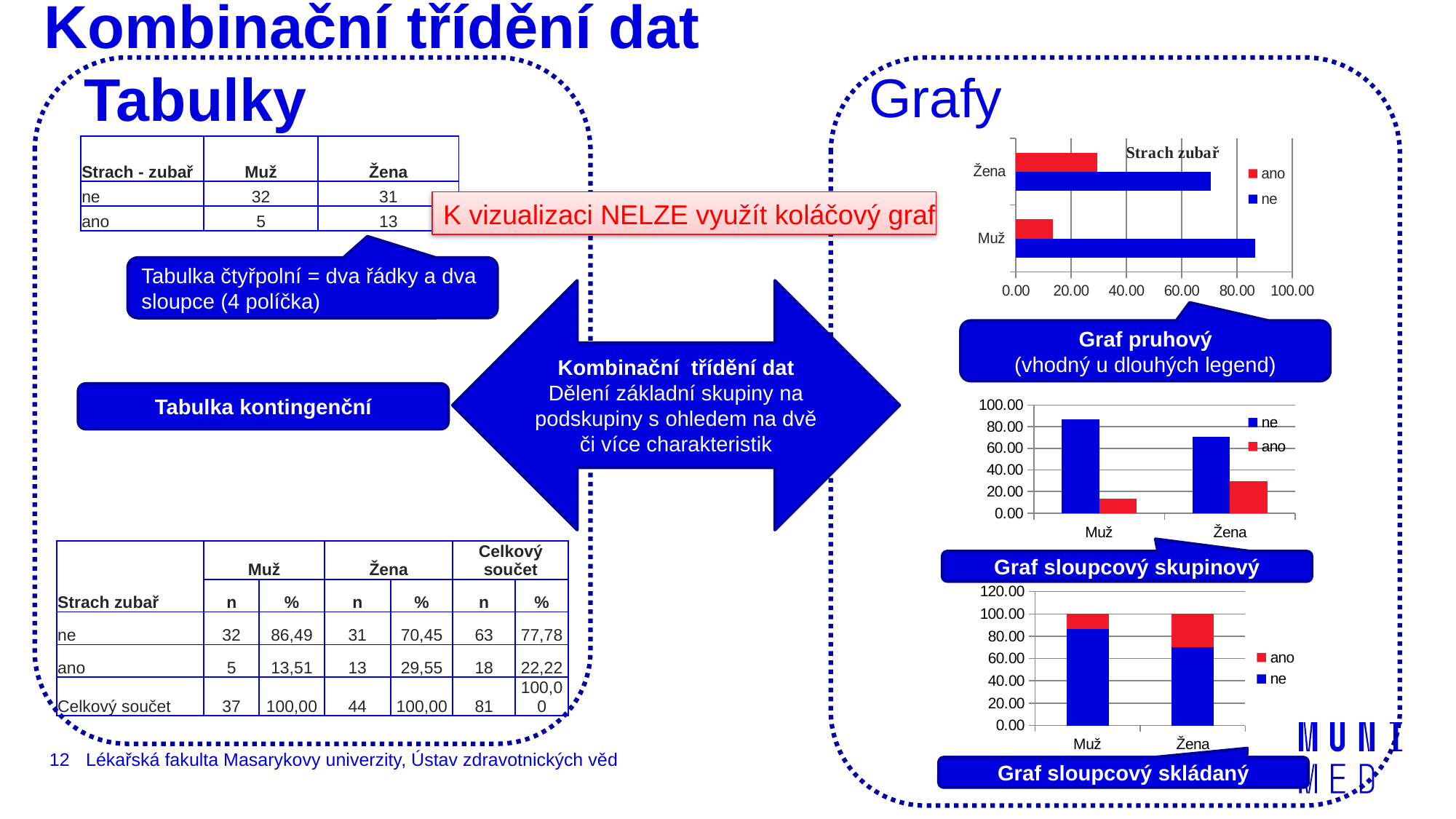
In the "Strach zubař" chart, is the value of "ne" for Muž greater or less than 80.00? greater Which legend entries are listed in the bottom-right stacked bar chart? ano, ne How many categories are shown on the vertical axis of the "Strach zubař" chart? 2 In the middle-right grouped bar chart, which category has the highest "ano" bar? Žena In the middle-right grouped bar chart, which category has the larger "ne" bar, Muž or Žena? Muž What is the title of the top-right horizontal bar chart? Strach zubař How many series does the legend of the "Strach zubař" chart list? 2 In the bottom-right stacked bar chart, what is the total height of the Muž bar? 100.00 What kind of chart is the top-right chart titled "Strach zubař"? bar chart In the middle-right grouped bar chart, which bar is the lowest? ano for Muž In the "Strach zubař" chart, is the value of "ano" for Žena greater or less than 20.00? greater In the bottom-right stacked bar chart, is the "ne" portion for Žena greater or less than 60.00? greater